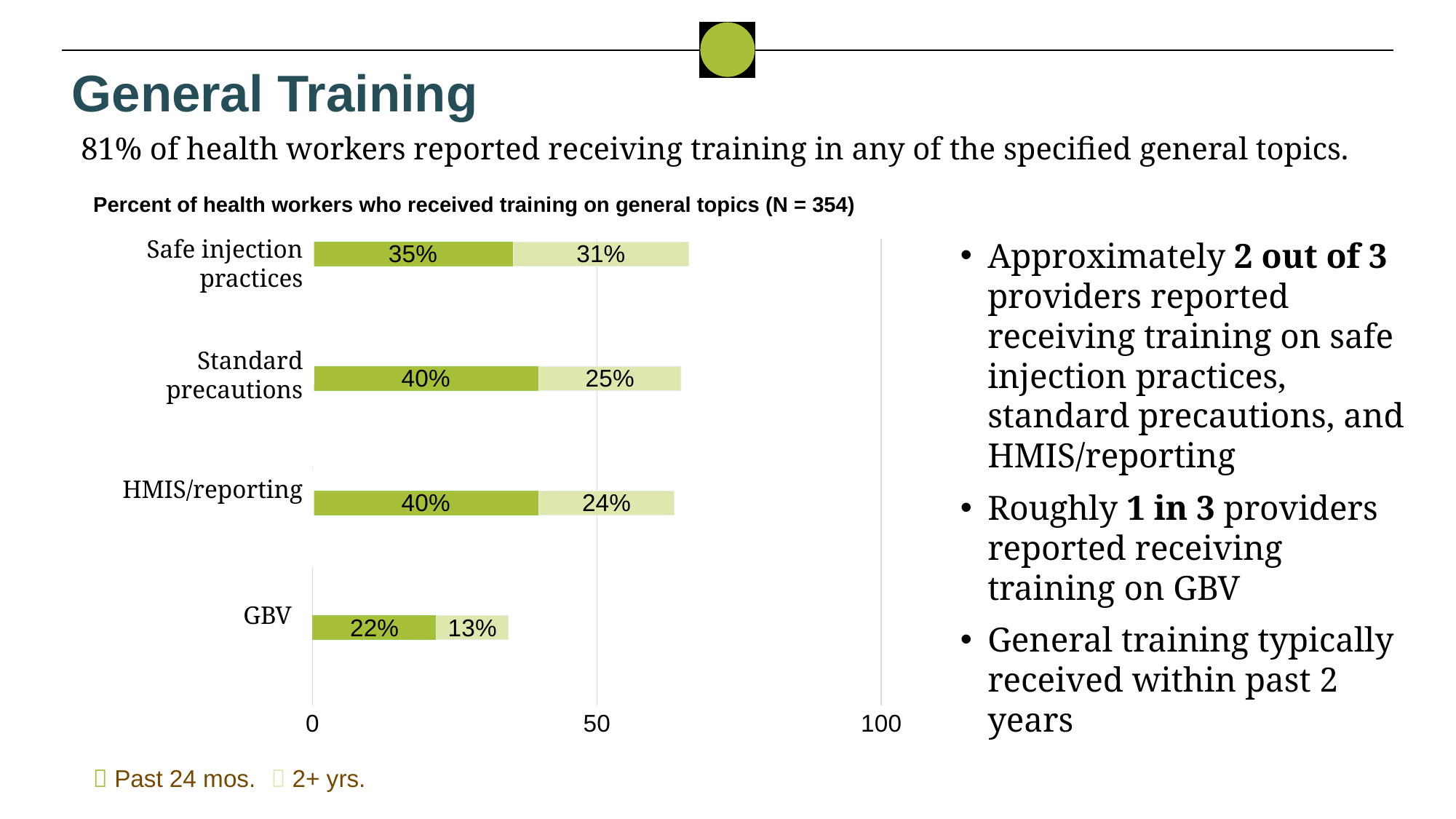
Which topic has the highest '2+ yrs.' value? Safe injection practices What percentage of health workers received training on safe injection practices in the past 24 months? 35% How many topics are shown in the chart? 4 Which topic has the lowest 'Past 24 mos.' value? GBV What kind of chart is shown on the slide? Stacked bar chart What is the total of the stacked bar for GBV? 35% What is the 'Past 24 mos.' value for HMIS/reporting? 40% Which is larger: the '2+ yrs.' value for Standard precautions or for GBV? Standard precautions What is the total of the stacked bar for Safe injection practices? 66% How many series does the legend list? 2 What percentage of health workers received training on GBV 2+ years ago? 13% What is the difference between the 'Past 24 mos.' values for Standard precautions and GBV? 18%